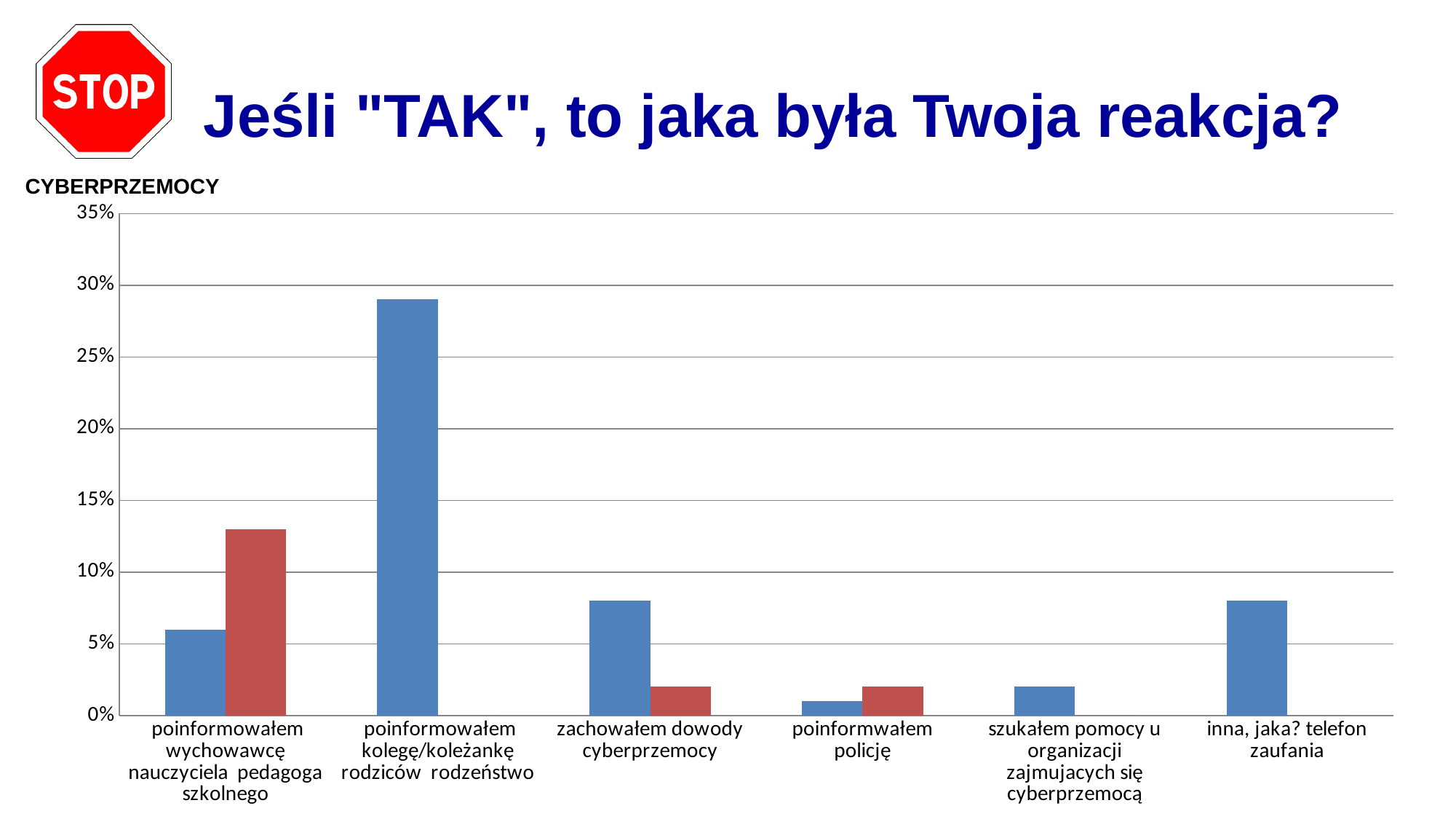
What kind of chart is shown on the slide? bar chart Is the blue bar for "poinformowałem wychowawcę nauczyciela pedagoga szkolnego" greater or less than 10%? less How many categories are shown along the x axis of the chart? 6 What is the highest value shown on the vertical axis of the chart? 35% Is the blue bar for "inna, jaka? telefon zaufania" greater or less than 5%? greater For "poinformowałem wychowawcę nauczyciela pedagoga szkolnego", which bar is taller, the blue one or the red one? the red one For "zachowałem dowody cyberprzemocy", which bar is taller, the blue one or the red one? the blue one Is the red bar for "poinformowałem wychowawcę nauczyciela pedagoga szkolnego" greater or less than 10%? greater Which category has the shortest blue bar? poinformwałem policję Which category has the tallest bar in the chart? poinformowałem kolegę/koleżankę rodziców rodzeństwo